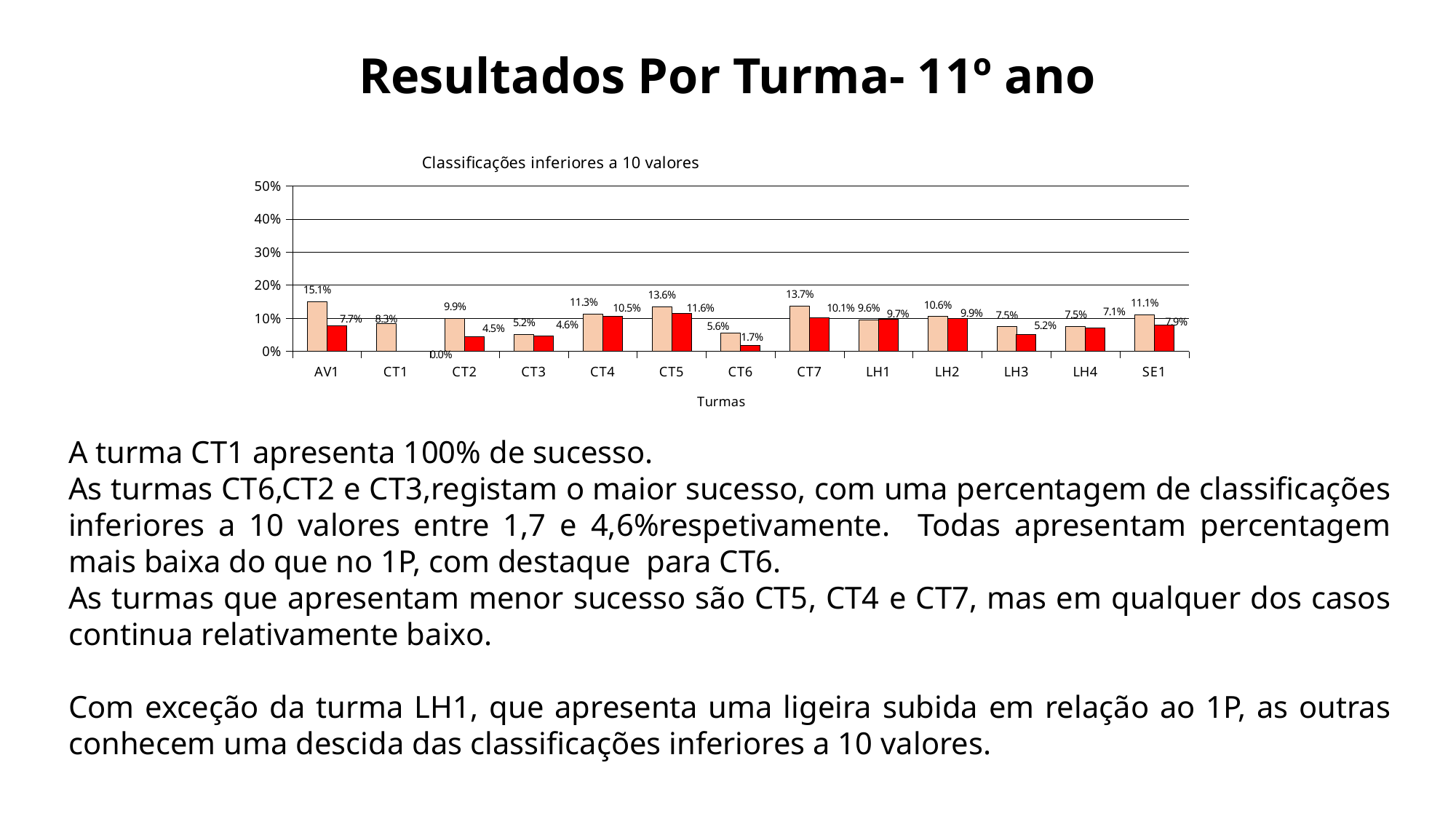
How many turmas are shown on the x axis? 13 What is the value of the light (peach) bar for AV1? 15.1% What is the value of the red bar for CT6? 1.7% Which is larger for LH1, the light (peach) bar or the red bar? the red bar What is the value of the red bar for CT1? 0.0% Which turma has the lowest red bar? CT1 What is the title of the chart? Classificações inferiores a 10 valores Which turma has the highest light (peach) bar? AV1 What kind of chart is shown on the slide? bar chart What is the difference between the light (peach) bar and the red bar for AV1? 7.4% Which turma has the highest red bar? CT5 What is the difference between the red bars for CT5 and CT6? 9.9%